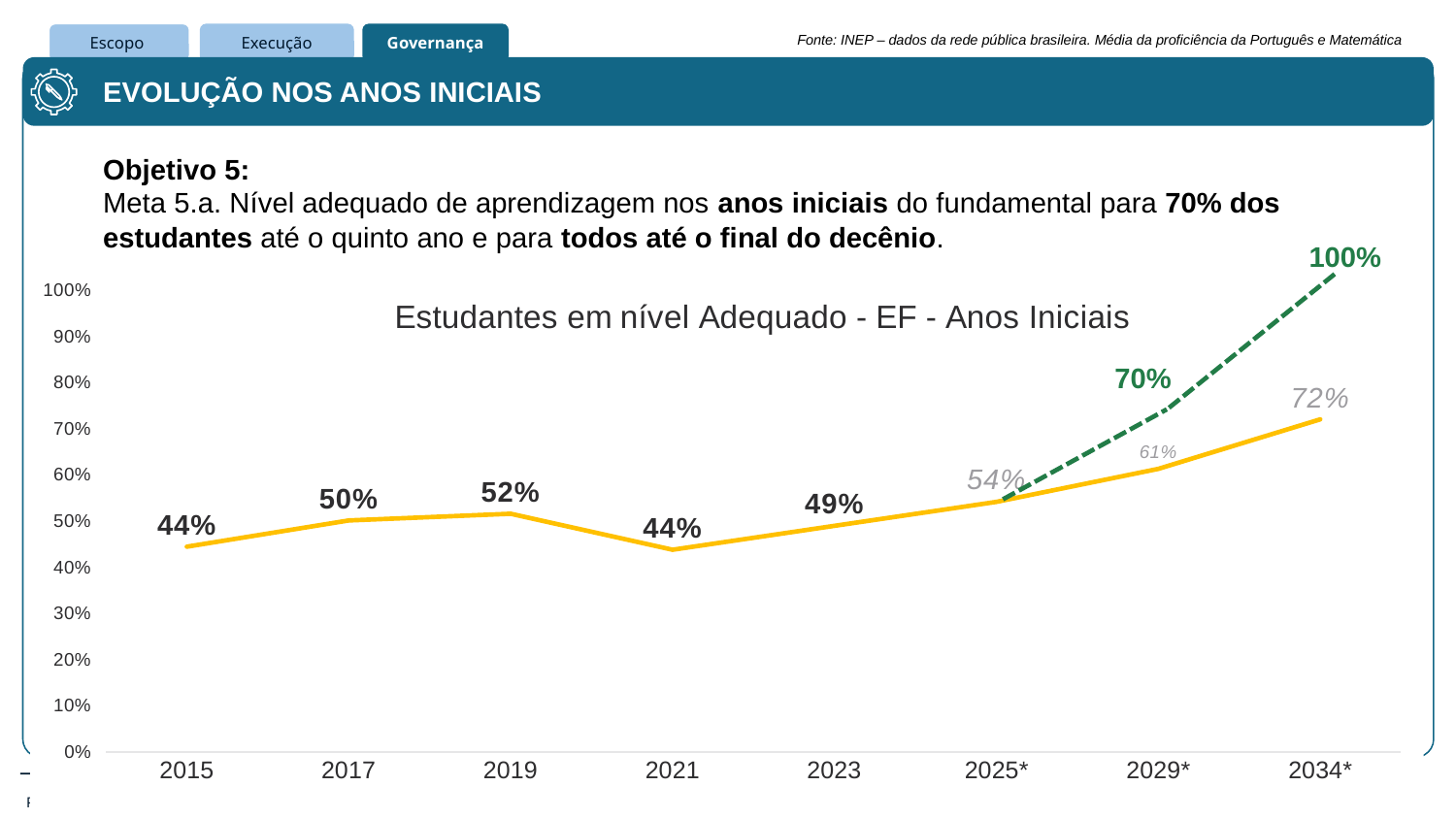
What is the value shown for 2034* on the green dashed line? 100% What is the value shown for 2029* on the green dashed line? 70% What is the title of the chart? Estudantes em nível Adequado - EF - Anos Iniciais What is the difference between the yellow line values for 2023 and 2021? 5% What is the value shown for 2029* on the yellow line? 61% What is the value shown for 2015 on the yellow line? 44% What is the difference between the green dashed line and the yellow line at 2034*? 28% Between 2019 and 2021, does the yellow line rise or fall? fall What type of chart is shown on the slide? line chart What is the value shown for 2019 on the yellow line? 52% How many years are shown on the x axis? 8 Which is larger, the value for 2019 or the value for 2021 on the yellow line? 2019